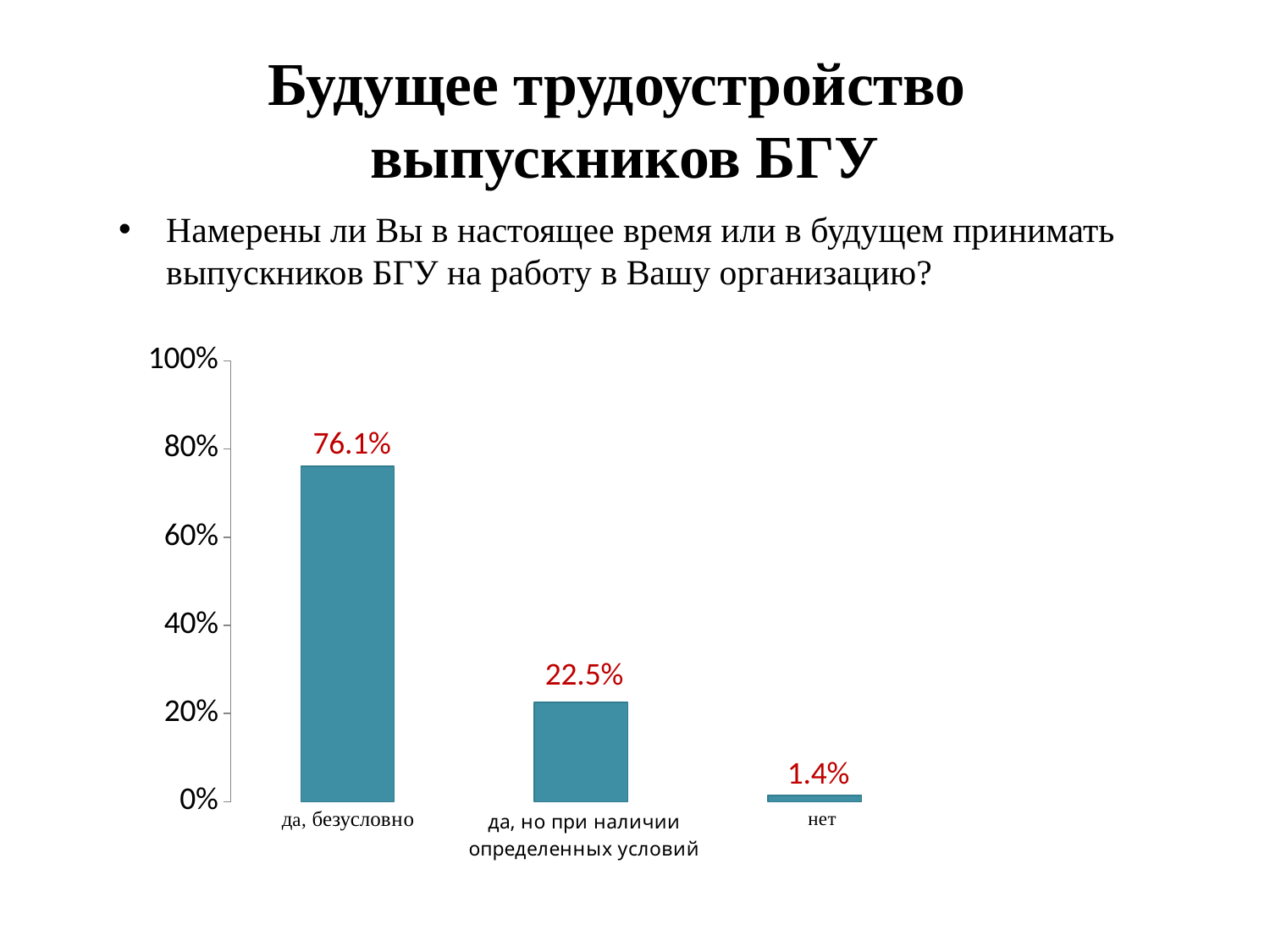
What is the value for "да, но при наличии определенных условий"? 22.5% Which is larger: the value for "да, но при наличии определенных условий" or the value for "нет"? да, но при наличии определенных условий What is the value for "нет"? 1.4% What is the value for "да, безусловно"? 76.1% Which category has the lowest value? нет How many categories are shown on the chart? 3 What is the difference between the values for "да, безусловно" and "да, но при наличии определенных условий"? 53.6% Which category has the highest value? да, безусловно What kind of chart is shown on the slide? bar chart What is the difference between the values for "да, но при наличии определенных условий" and "нет"? 21.1% Is the value for "да, безусловно" greater or less than 80%? less Do the values rise or fall from left to right along the x axis? fall